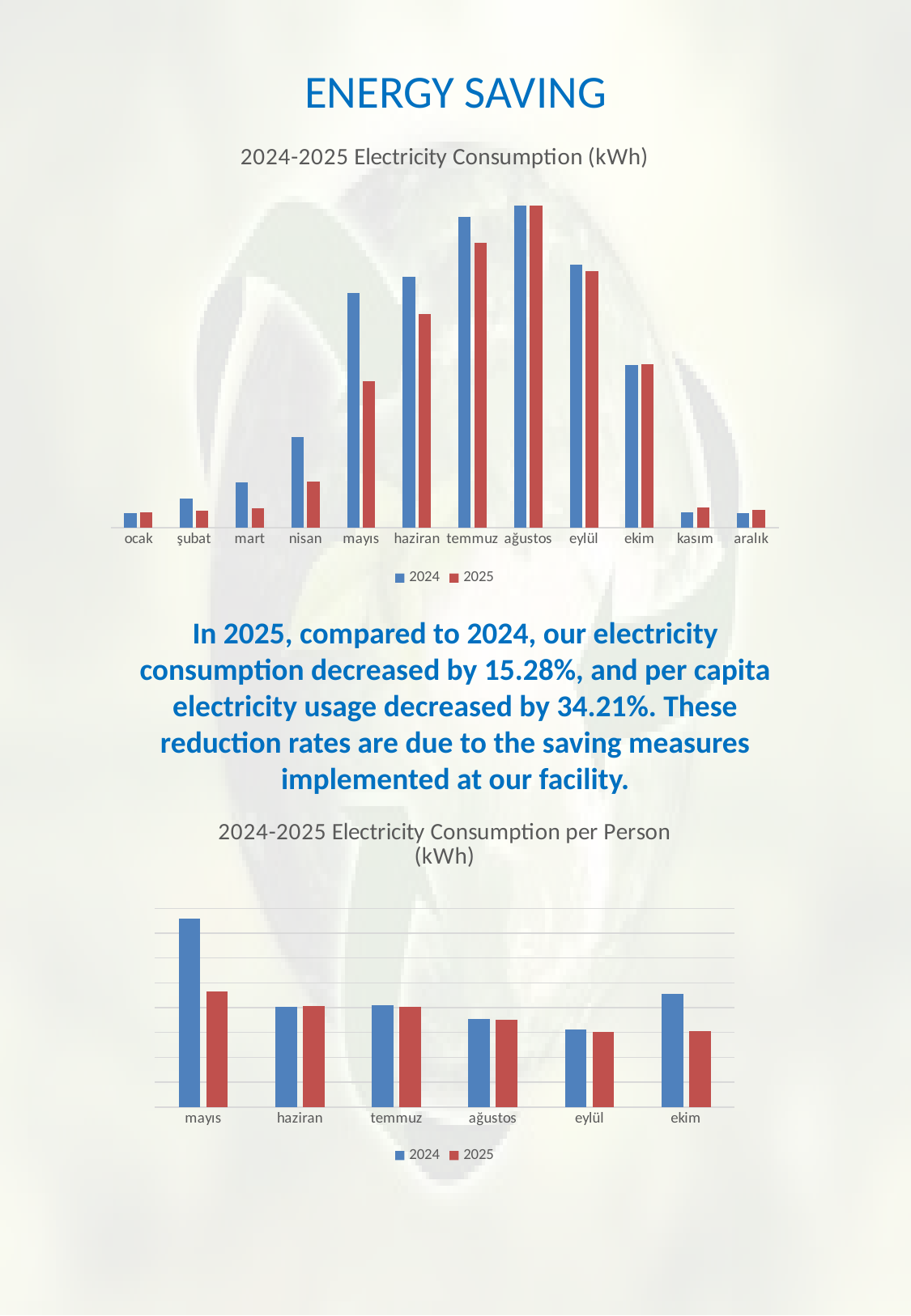
In the '2024-2025 Electricity Consumption (kWh)' chart, is the mayıs value larger for 2024 or 2025? 2024 How many series does the legend of the '2024-2025 Electricity Consumption (kWh)' chart list? 2 In the '2024-2025 Electricity Consumption (kWh)' chart, is the nisan value larger for 2024 or 2025? 2024 What kind of chart is the '2024-2025 Electricity Consumption per Person (kWh)' chart? bar chart How many months are shown on the x axis of the '2024-2025 Electricity Consumption (kWh)' chart? 12 How many months are shown on the x axis of the '2024-2025 Electricity Consumption per Person (kWh)' chart? 6 In the '2024-2025 Electricity Consumption per Person (kWh)' chart, which month has the lowest 2024 value? eylül In the '2024-2025 Electricity Consumption (kWh)' chart, which month has the highest 2025 value? ağustos In the '2024-2025 Electricity Consumption per Person (kWh)' chart, which month has the highest 2024 value? mayıs In the '2024-2025 Electricity Consumption (kWh)' chart, do the 2024 values rise or fall from ocak to ağustos? rise What kind of chart is the '2024-2025 Electricity Consumption (kWh)' chart? bar chart In the '2024-2025 Electricity Consumption (kWh)' chart, which month has the highest 2024 value? ağustos